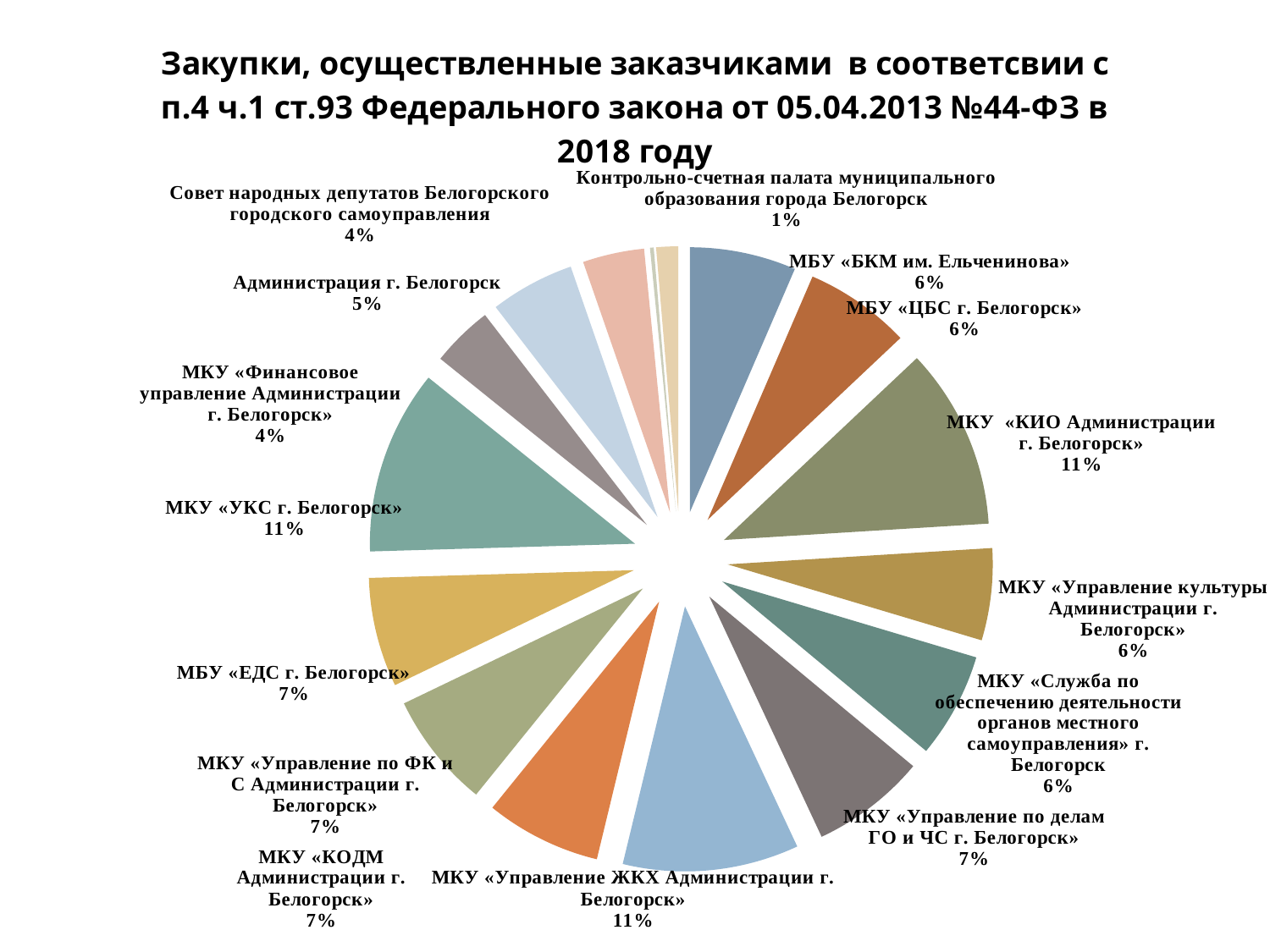
What percentage is shown for Администрация г. Белогорск? 5% What kind of chart is shown on the slide? pie chart What share of the pie does МКУ «Управление ЖКХ Администрации г. Белогорск» hold? 11% What share of the pie does МКУ «КИО Администрации г. Белогорск» hold? 11% What percentage is shown for Совет народных депутатов Белогорского городского самоуправления? 4% Which has the larger share: МКУ «Управление по делам ГО и ЧС г. Белогорск» or Контрольно-счетная палата муниципального образования города Белогорск? МКУ «Управление по делам ГО и ЧС г. Белогорск» What percentage is shown for МБУ «ЕДС г. Белогорск»? 7% What is the difference in percentage points between МКУ «УКС г. Белогорск» (11%) and Администрация г. Белогорск (5%)? 6% What percentage is shown for МКУ «Финансовое управление Администрации г. Белогорск»? 4% Which has the larger share: МКУ «УКС г. Белогорск» or Администрация г. Белогорск? МКУ «УКС г. Белогорск» What share is shown for Контрольно-счетная палата муниципального образования города Белогорск? 1% Which year does the chart title say the purchases refer to? 2018